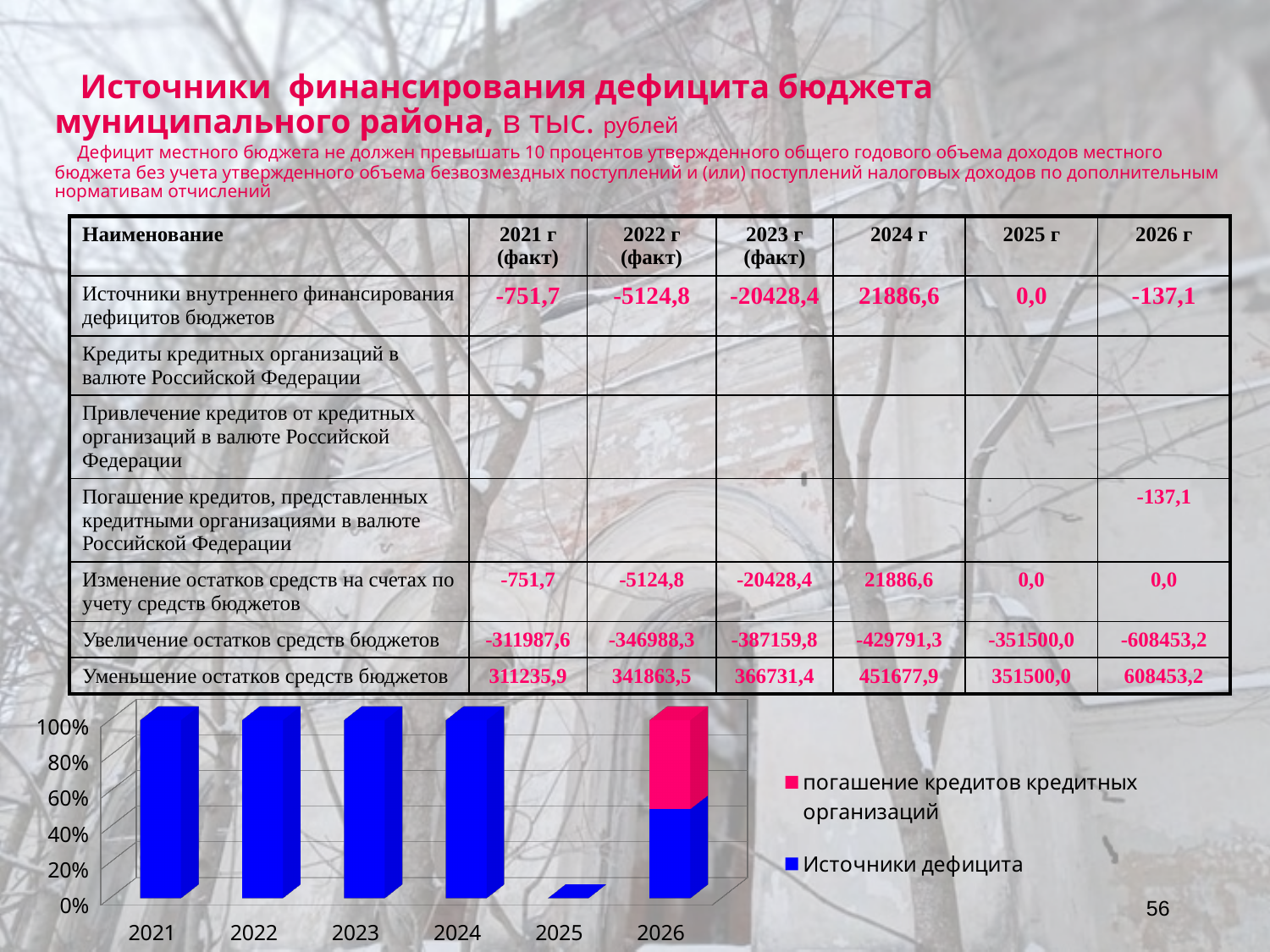
In the bar chart, is the blue segment (Источники дефицита) for 2021 greater or less than 80%? greater In the bar chart, which year is the only one with a visible pink segment (погашение кредитов кредитных организаций)? 2026 Which series in the bar chart is shown in pink? погашение кредитов кредитных организаций How many series does the legend of the bar chart list? 2 How many years are shown on the x axis of the bar chart? 6 In the bar chart, which year has the smallest total bar? 2025 Which series in the bar chart is shown in blue? Источники дефицита In the bar chart, is the blue segment (Источники дефицита) for 2026 greater or less than 80%? less In the bar chart, is the pink segment (погашение кредитов кредитных организаций) for 2026 greater or less than 20%? greater In the bar chart, is the blue segment for 2024 larger or smaller than the blue segment for 2026? larger What kind of chart is shown at the bottom of the slide? bar chart